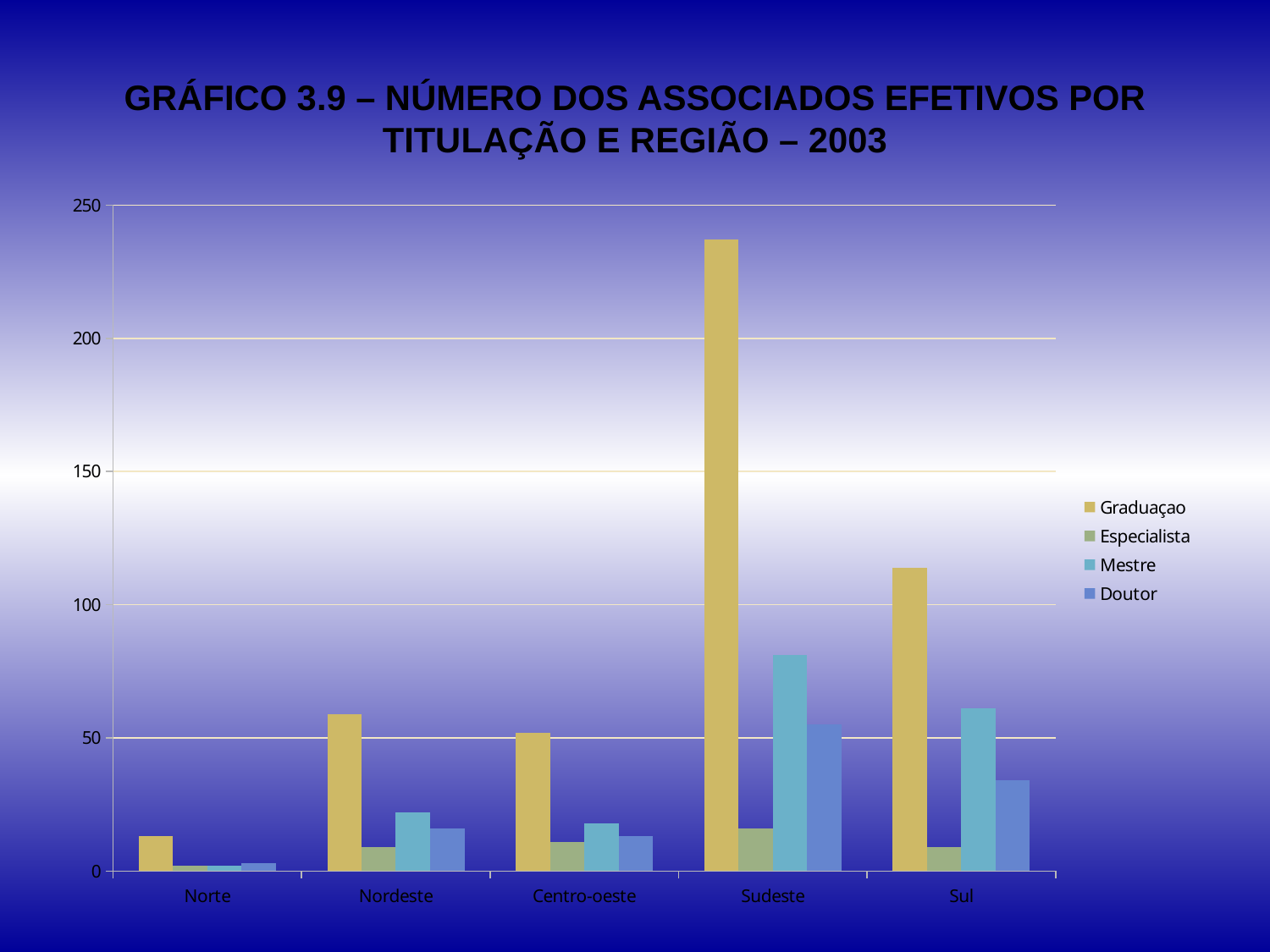
In Sudeste, which is larger: the value for Mestre or the value for Doutor? Mestre Is the value for Graduaçao in Nordeste greater or less than 50? greater Is the value for Mestre in Sudeste greater or less than 100? less Which region has the highest value for Graduaçao? Sudeste What kind of chart is shown on the slide? bar chart Which series is shown in yellow in the legend? Graduaçao How many series does the legend list? 4 Is the value for Graduaçao in Sudeste greater or less than 200? greater Which is larger: the value for Graduaçao in Nordeste or in Centro-oeste? Nordeste Which region has the lowest value for Graduaçao? Norte How many regions are shown on the x axis? 5